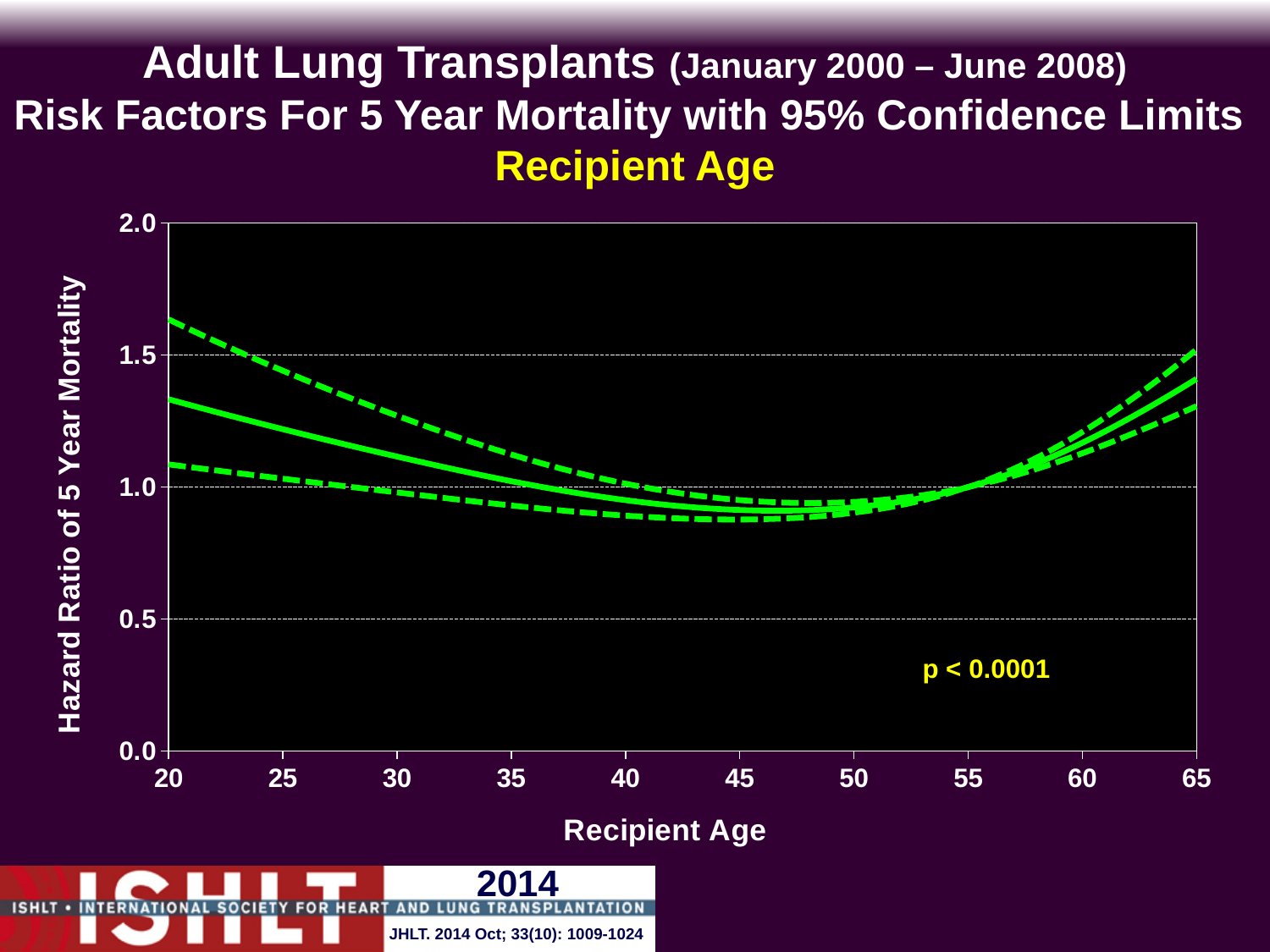
How many lines are plotted on the chart? 3 Is the lower dashed confidence limit at recipient age 65 greater or less than 1.5? less Does the solid hazard ratio line rise or fall as recipient age increases from 55 to 65? rise Is the upper dashed confidence limit at recipient age 20 greater or less than 1.5? greater Is the hazard ratio on the solid line at recipient age 20 greater or less than 1.0? greater Does the solid hazard ratio line rise or fall as recipient age increases from 20 to 45? fall How many tick labels are shown on the x axis? 10 What is the label of the y axis? Hazard Ratio of 5 Year Mortality What kind of chart is shown on the slide? Line chart What is the label of the x axis? Recipient Age